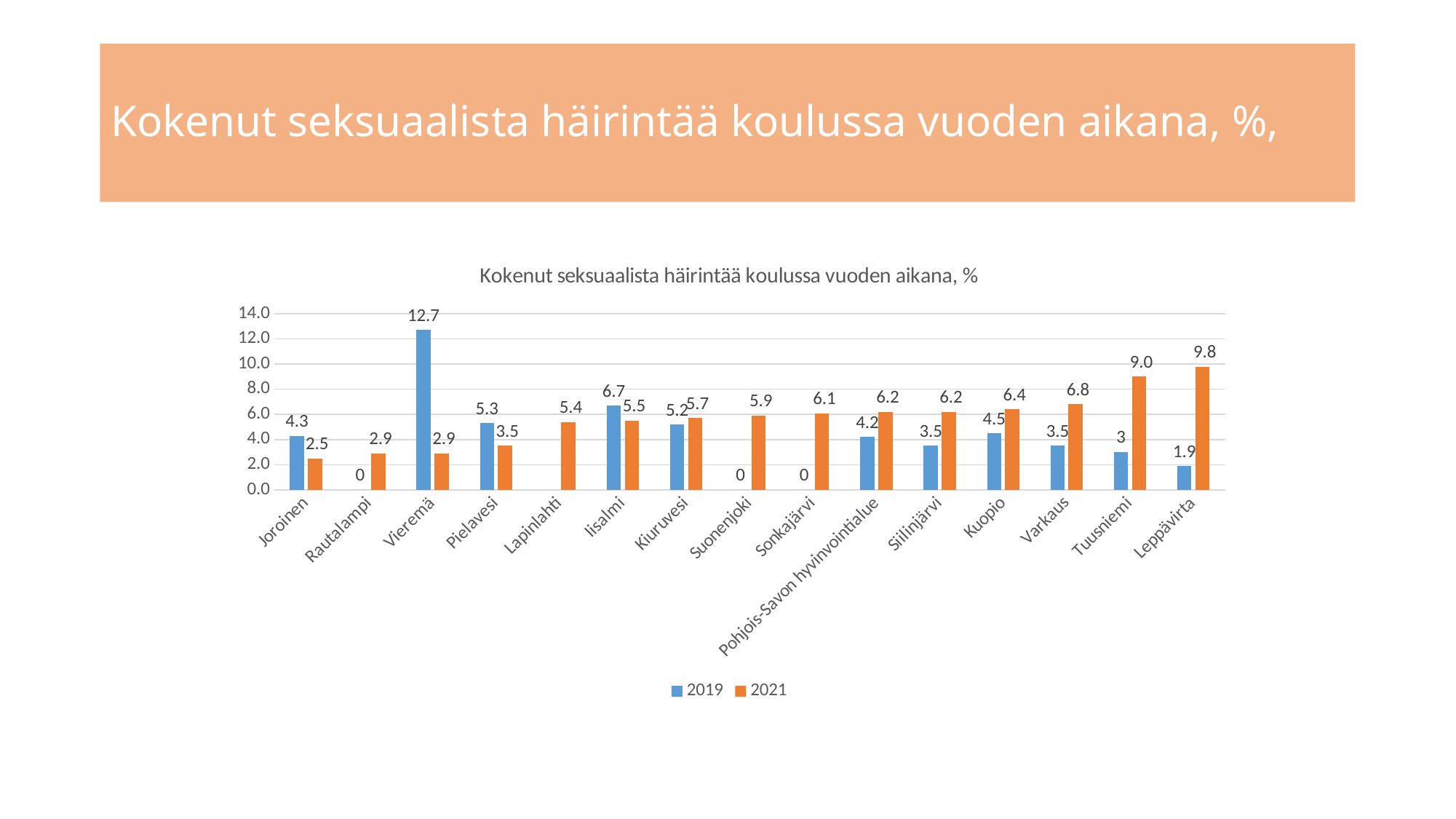
How many categories are shown on the x axis? 15 What kind of chart is shown on the slide? Bar chart What is the 2019 value for Vieremä? 12.7 Which category has the highest 2021 value? Leppävirta Which is larger for Iisalmi, the 2019 value or the 2021 value? 2019 How many series does the legend list? 2 Which category has the highest 2019 value? Vieremä What is the difference between the 2019 and 2021 values for Vieremä? 9.8 What is the difference between the 2021 values for Tuusniemi and Joroinen? 6.5 What is the 2021 value for Lapinlahti? 5.4 What is the 2019 value for Pohjois-Savon hyvinvointialue? 4.2 What is the 2021 value for Leppävirta? 9.8